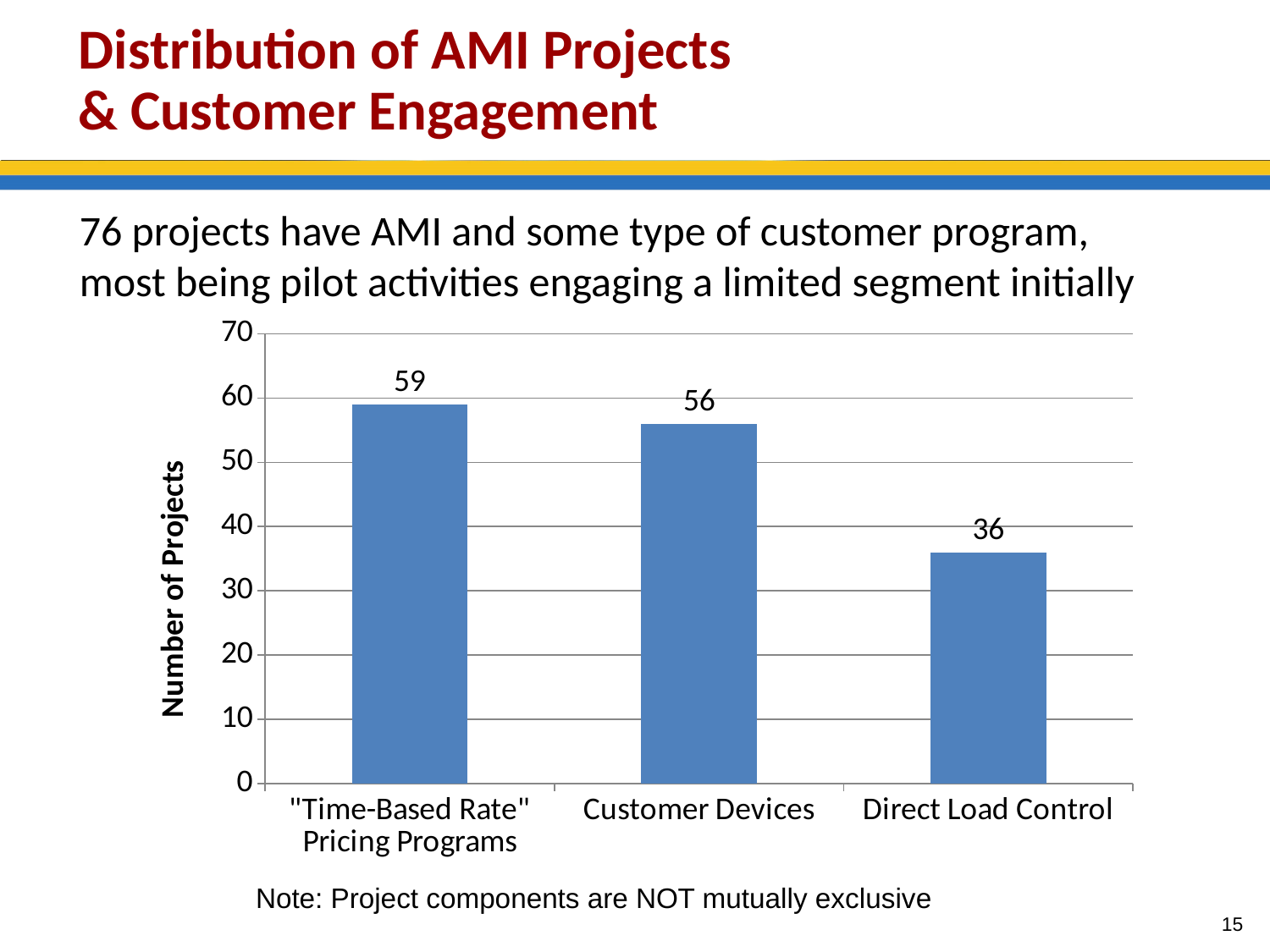
Which has more projects, Customer Devices or Direct Load Control? Customer Devices What is the difference in number of projects between Customer Devices and Direct Load Control? 20 What is the number of projects for "Time-Based Rate" Pricing Programs? 59 Which category has the lowest number of projects? Direct Load Control What is the difference in number of projects between "Time-Based Rate" Pricing Programs and Direct Load Control? 23 Which category has the highest number of projects? "Time-Based Rate" Pricing Programs What is the label of the vertical axis of the chart? Number of Projects What is the number of projects for Direct Load Control? 36 What is the number of projects for Customer Devices? 56 How many categories are shown in the chart? 3 Is the value for Direct Load Control greater or less than 40? less What kind of chart is shown on the slide? bar chart